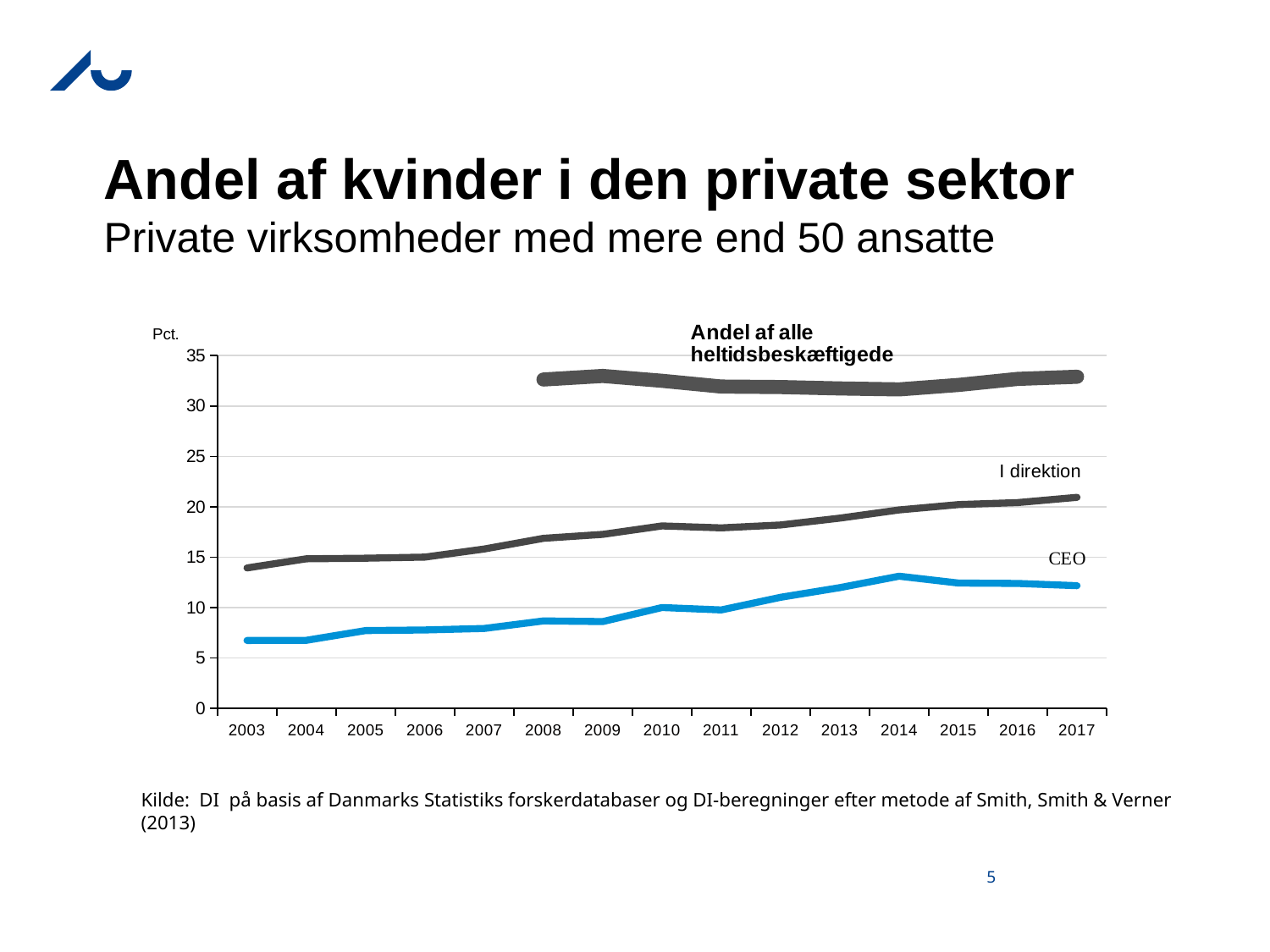
How many years are shown on the x axis of the chart? 15 Which series has the lowest values in the chart? CEO Is the value for I direktion in 2017 greater or less than 20? greater Is the value for Andel af alle heltidsbeskæftigede in 2008 greater or less than 30? greater Is the value for CEO in 2014 greater or less than 10? greater Does the I direktion line rise or fall from 2003 to 2017? rise Which series has the highest values in the chart? Andel af alle heltidsbeskæftigede In 2017, which is larger: I direktion or CEO? I direktion How many series (lines) are plotted in the chart? 3 What kind of chart is shown on the slide? line chart What unit label is shown at the top of the y axis? Pct.